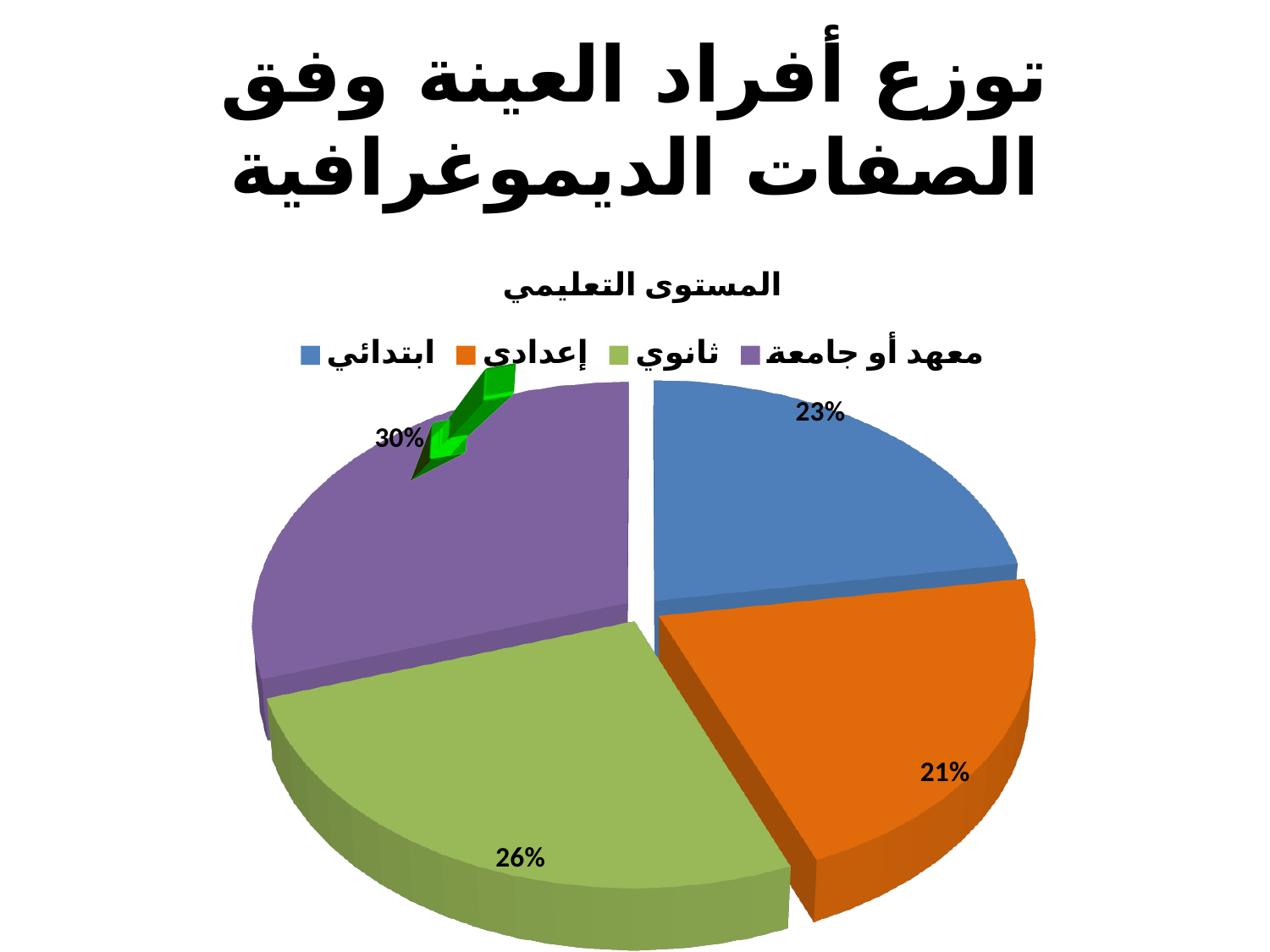
How many entries does the legend list? 4 What percentage is shown for ابتدائي? 23% Which is larger, the share for ثانوي or the share for ابتدائي? ثانوي What kind of chart is shown on the slide? pie chart What percentage is shown for إعدادي? 21% Which category has the largest share of the pie? معهد أو جامعة What is the difference in percentage points between معهد أو جامعة and إعدادي? 9 What percentage is shown for معهد أو جامعة? 30% What percentage is shown for ثانوي? 26% Which category has the smallest share of the pie? إعدادي How many slices does the pie chart have? 4 What is the title of the chart? المستوى التعليمي